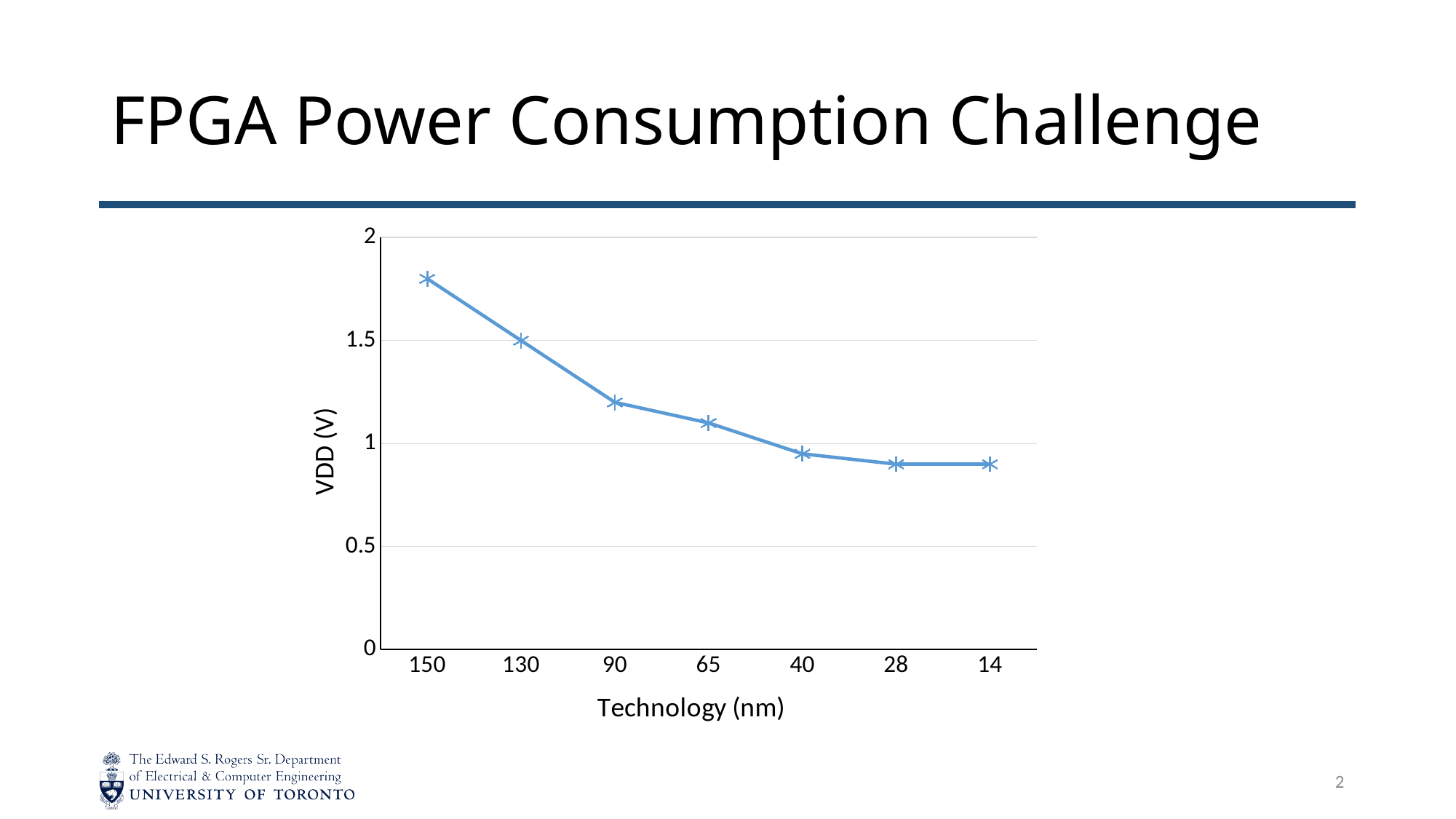
Is the VDD value at 14 nm greater or less than 1? less What is the label of the x axis? Technology (nm) How many technology nodes are plotted on the x axis? 7 What is the label of the y axis? VDD (V) Which has a higher VDD, the 150 nm node or the 90 nm node? 150 nm Which technology node has the highest VDD? 150 nm Is the VDD value at 90 nm greater or less than 1? greater Does VDD rise or fall as the technology node moves from 150 nm to 14 nm along the x axis? fall What kind of chart is shown on the slide? line chart Is the VDD value at 40 nm greater or less than 1? less What is the VDD value at the 130 nm technology node? 1.5